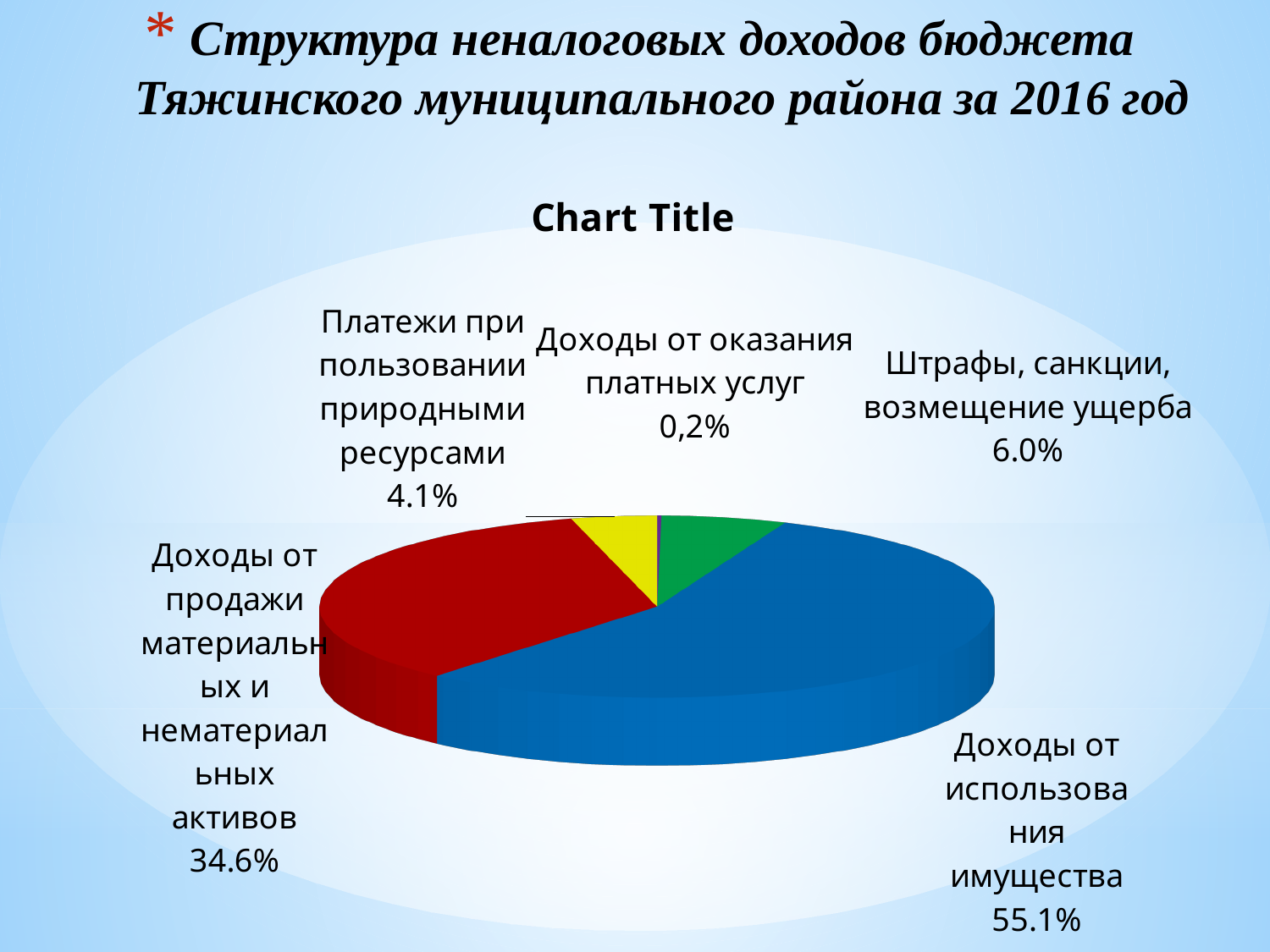
What share of the pie is labelled "Доходы от использования имущества"? 55.1% What kind of chart is shown on the slide? Pie chart Which category has the largest share of the pie? Доходы от использования имущества Which category has the smallest share of the pie? Доходы от оказания платных услуг What title is printed directly above the pie chart? Chart Title What value is shown for "Доходы от продажи материальных и нематериальных активов"? 34.6% Which is larger: "Штрафы, санкции, возмещение ущерба" or "Платежи при пользовании природными ресурсами"? Штрафы, санкции, возмещение ущерба What is the difference in percentage points between "Доходы от использования имущества" and "Доходы от продажи материальных и нематериальных активов"? 20.5 How many slices does the pie chart have? 5 What value is shown for "Штрафы, санкции, возмещение ущерба"? 6.0% What value is shown for "Платежи при пользовании природными ресурсами"? 4.1% What value is shown for "Доходы от оказания платных услуг"? 0,2%